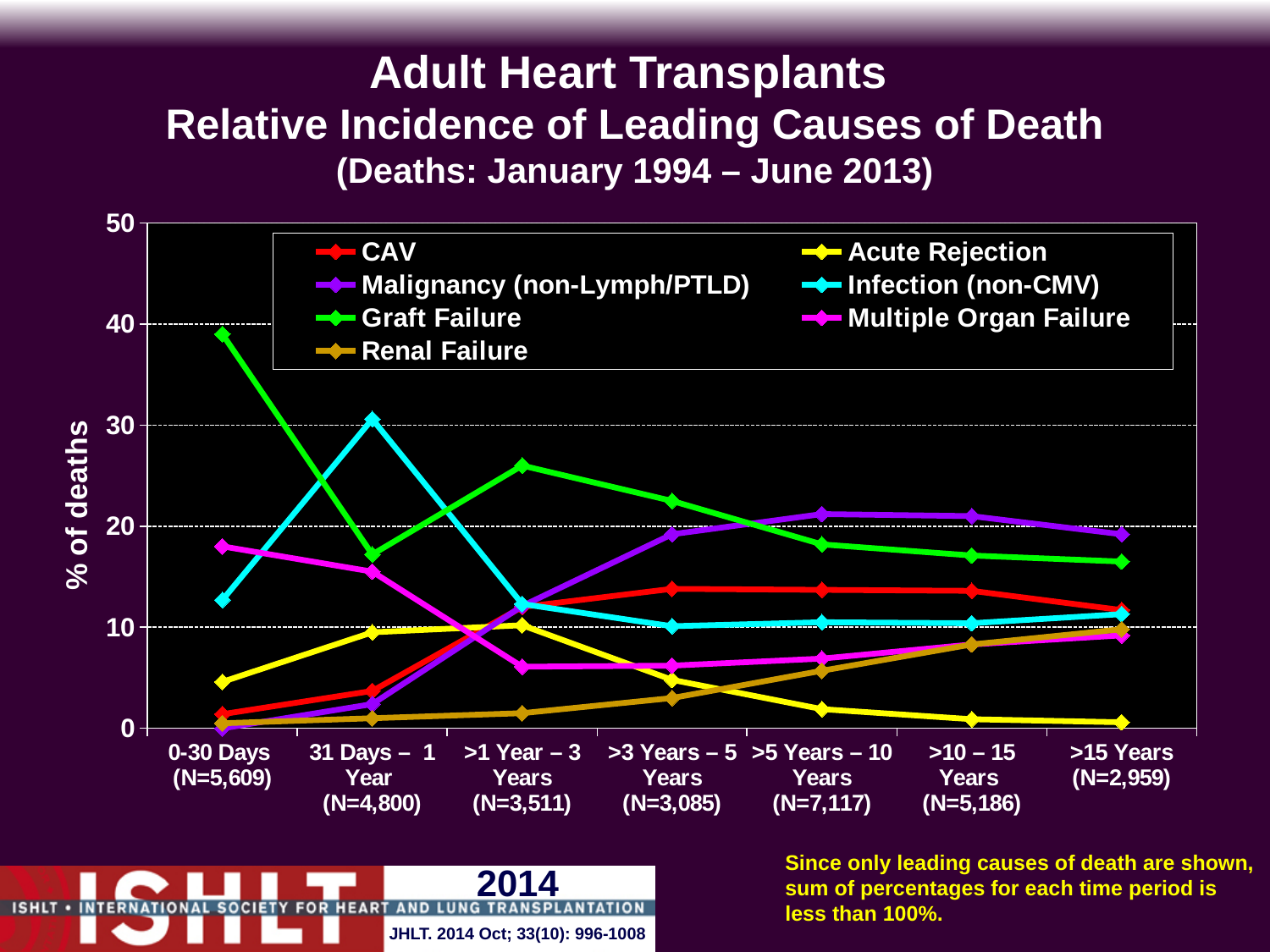
Which cause of death has the lowest % of deaths in the >15 Years period? Acute Rejection Is the value for Graft Failure in the 0-30 Days period greater or less than 30? greater Is the value for Acute Rejection in the >15 Years period greater or less than 10? less In the >5 Years – 10 Years period, which is larger: Malignancy (non-Lymph/PTLD) or Graft Failure? Malignancy (non-Lymph/PTLD) Is the value for Infection (non-CMV) in the 31 Days – 1 Year period greater or less than 20? greater What is the label on the y axis? % of deaths Which cause of death has the highest % of deaths in the 0-30 Days period? Graft Failure How many time periods are shown along the x axis? 7 Which cause of death has the highest % of deaths in the 31 Days – 1 Year period? Infection (non-CMV) Does the Renal Failure line rise or fall from the 0-30 Days period to the >15 Years period? rise What kind of chart is shown on the slide? line chart How many series does the legend list? 7